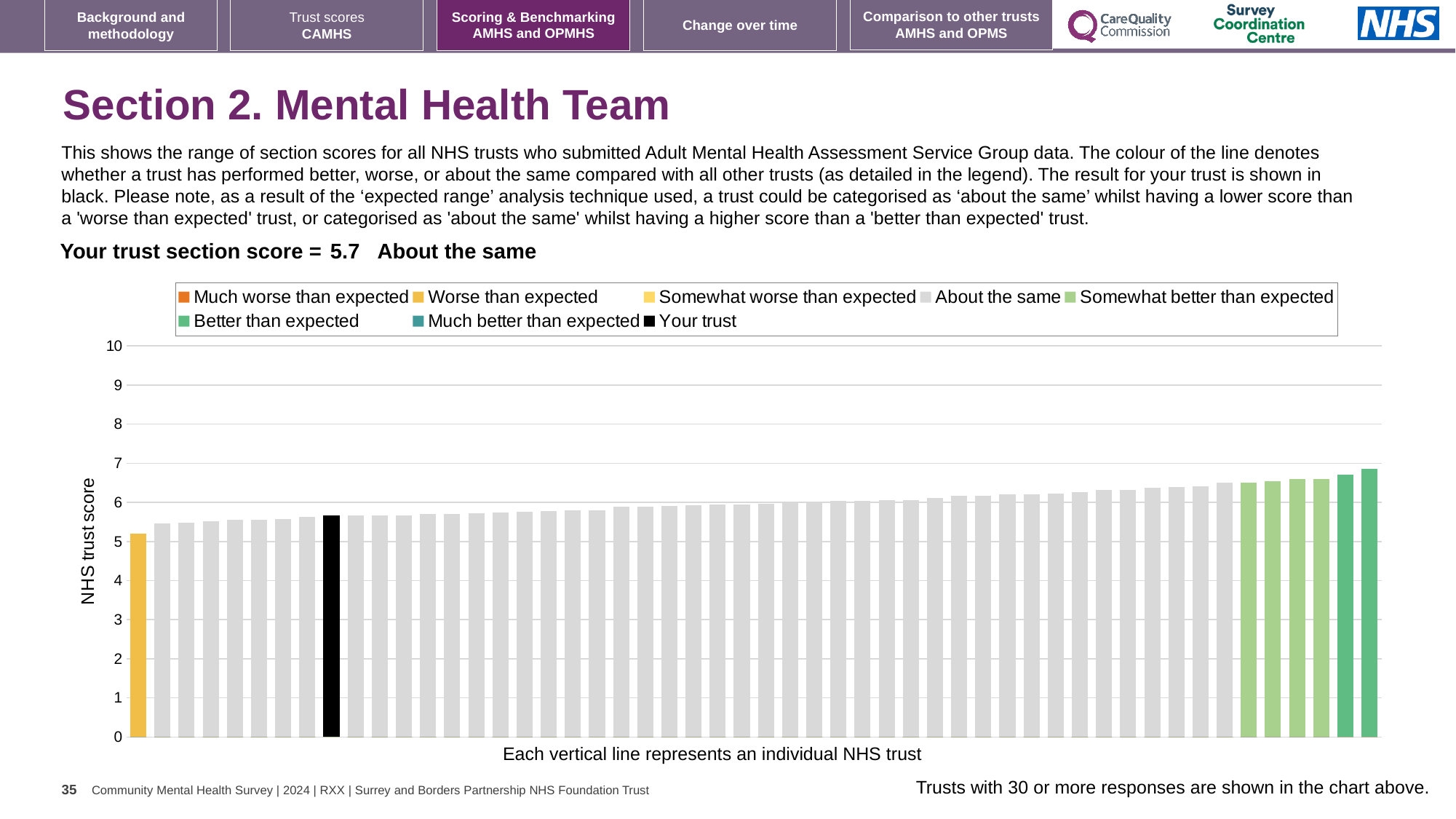
What is the section score for your trust shown on the slide? 5.7 Is the value of the black bar for your trust greater or less than 5? greater Is the value of the rightmost bar greater or less than 6? greater How many entries does the chart legend list? 8 Is the value of the black bar for your trust greater or less than 6? less What colour is the bar representing your trust? black Do the bar values rise or fall from left to right along the x axis? rise What kind of chart is shown on the slide? bar chart Which performance category is your trust placed in for this section? About the same Which bar is larger, the leftmost bar or the rightmost bar? the rightmost bar